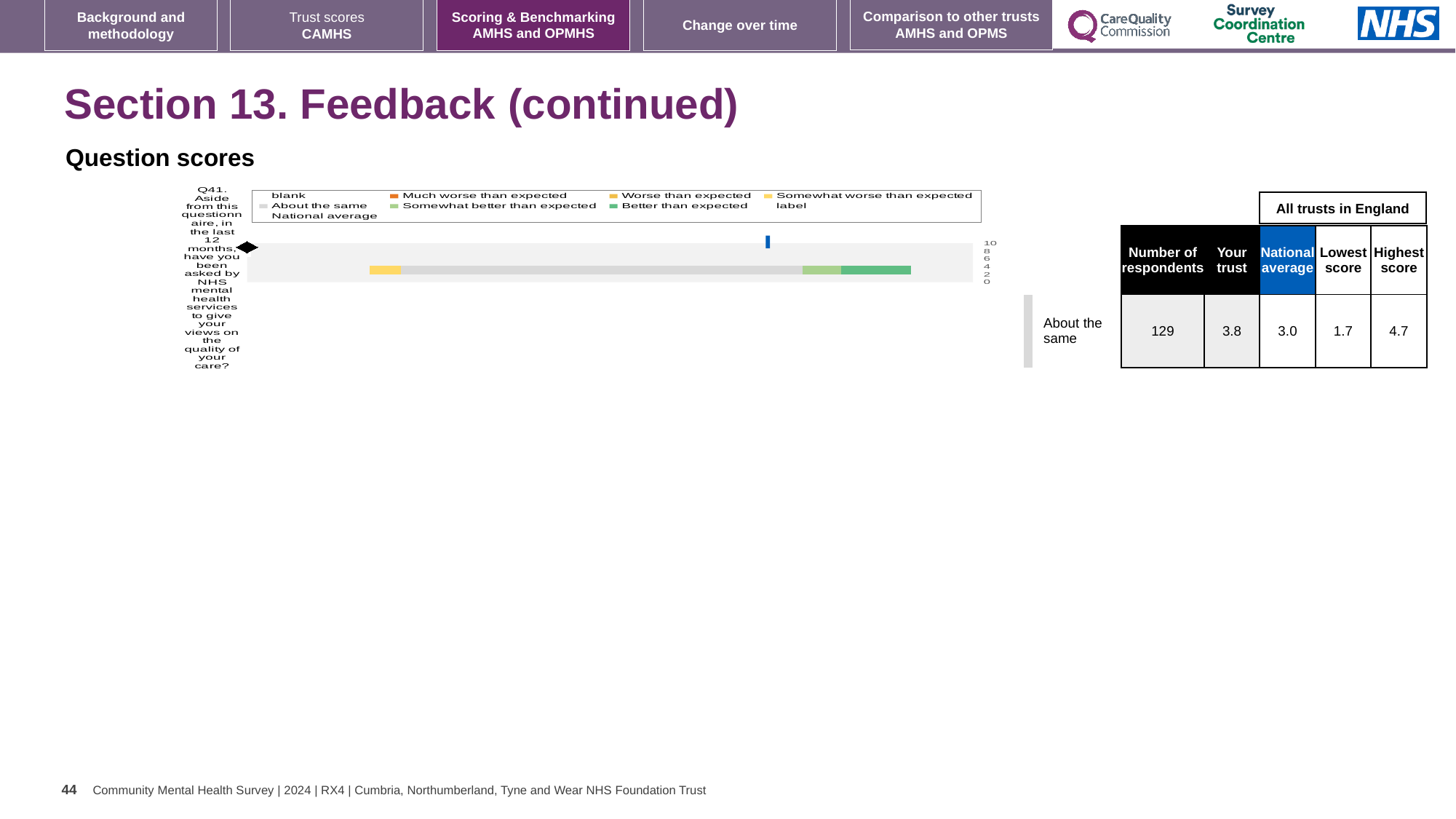
Which question number is plotted in the chart? Q41 What is the difference between the 'Your trust' score and the national average for Q41? 0.8 How many questions (categories) are plotted in the chart? 1 Which is larger for Q41: the 'Your trust' score or the national average? Your trust What is the difference between the highest and lowest scores among all trusts in England for Q41? 3.0 What colour is the 'Better than expected' legend entry in the chart? green In the table beside the chart, what is the lowest score among all trusts in England for Q41? 1.7 In the table beside the chart, what is the 'Your trust' score for Q41? 3.8 In the table beside the chart, what is the national average for Q41? 3.0 In the table beside the chart, what is the number of respondents for Q41? 129 In the table beside the chart, what is the highest score among all trusts in England for Q41? 4.7 What kind of chart is shown for Q41 on the slide? bar chart